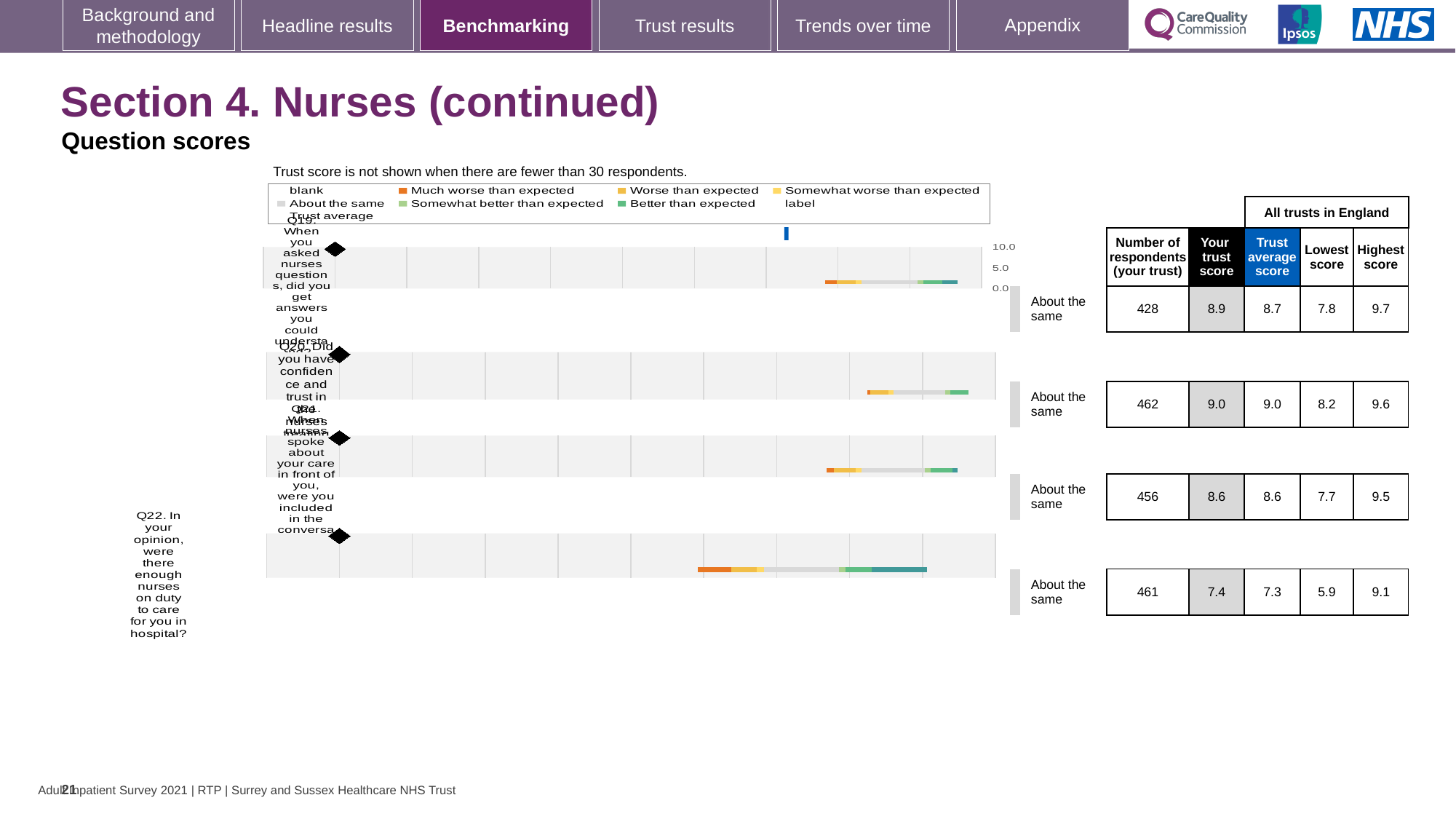
Is the trust score for Q22 greater or less than 5.0 on the chart axis? greater How many respondents answered Q21 for this trust? 456 Which question has the highest trust score? Q20 What is the trust score for Q22 (were there enough nurses on duty to care for you in hospital)? 7.4 How many questions (categories) are plotted in the chart? 4 What kind of chart is used to show the question scores on this slide? bar chart What is the difference between the trust score for Q19 and the trust score for Q22? 1.5 What is the trust score for Q19 (when you asked nurses questions, did you get answers you could understand)? 8.9 Which question has the lowest trust score? Q22 What is the highest value shown on the chart's score axis? 10.0 What is the trust average score for Q20 (did you have confidence and trust in the nurses)? 9.0 How many entries does the chart legend list? 9